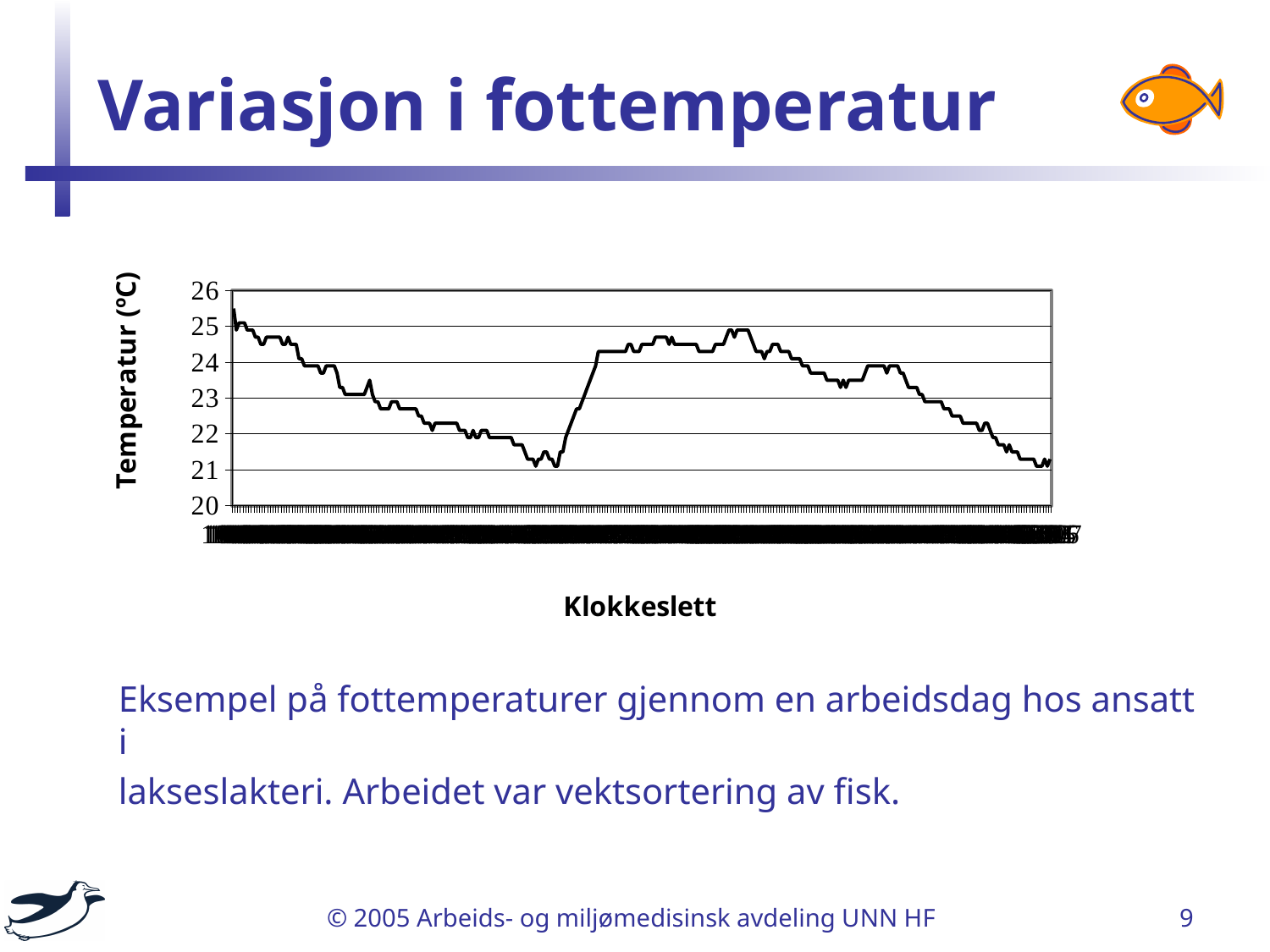
Is the temperature at the very end of the recording greater or less than 22? less Does the temperature line ever drop below 22 °C? yes What is the title of the x axis of the chart? Klokkeslett What is the highest value shown on the y axis of the chart? 26 What is the title of the y axis of the chart? Temperatur (°C) Is the temperature at the very start of the recording greater or less than 25? greater Overall, does the temperature rise or fall from the start to the end of the recording? fall What is the lowest value shown on the y axis of the chart? 20 What kind of chart is shown on the slide? line chart Is the temperature at the end of the recording higher or lower than at the start? lower